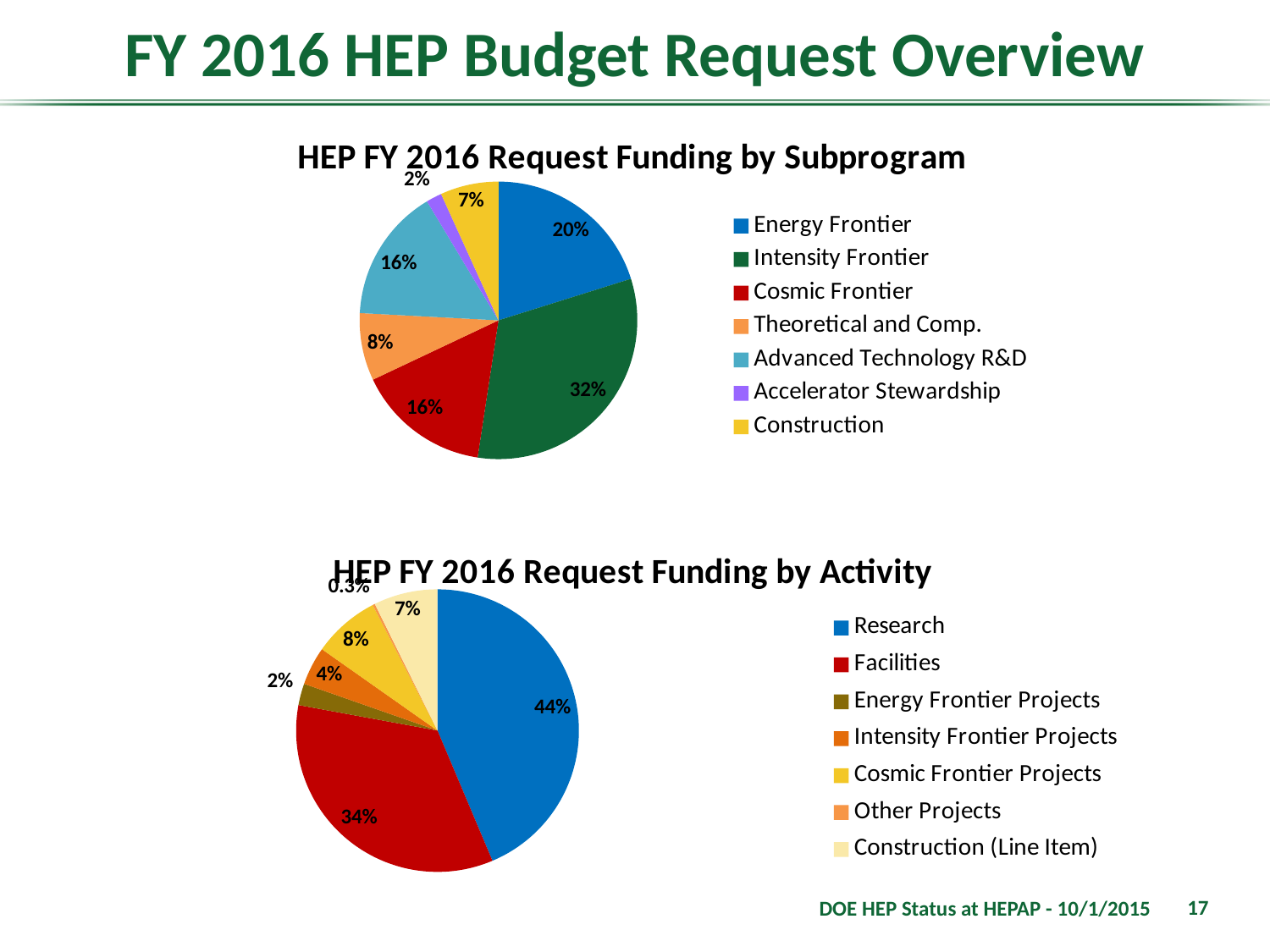
In the 'HEP FY 2016 Request Funding by Subprogram' chart, which subprogram has the largest share? Intensity Frontier In the 'HEP FY 2016 Request Funding by Activity' chart, which is larger, Cosmic Frontier Projects or Intensity Frontier Projects? Cosmic Frontier Projects In the 'HEP FY 2016 Request Funding by Activity' chart, what colour is the Research slice? Blue In the 'HEP FY 2016 Request Funding by Subprogram' chart, how many subprograms does the legend list? 7 In the 'HEP FY 2016 Request Funding by Subprogram' chart, what share does Energy Frontier have? 20% In the 'HEP FY 2016 Request Funding by Activity' chart, what share does Other Projects have? 0.3% In the 'HEP FY 2016 Request Funding by Activity' chart, what share does Facilities have? 34% What kind of chart is 'HEP FY 2016 Request Funding by Activity'? Pie chart In the 'HEP FY 2016 Request Funding by Subprogram' chart, which subprogram has the smallest share? Accelerator Stewardship In the 'HEP FY 2016 Request Funding by Subprogram' chart, what is the difference in percentage points between Intensity Frontier and Cosmic Frontier? 16 In the 'HEP FY 2016 Request Funding by Subprogram' chart, what share does Intensity Frontier have? 32% In the 'HEP FY 2016 Request Funding by Activity' chart, what share does Research have? 44%